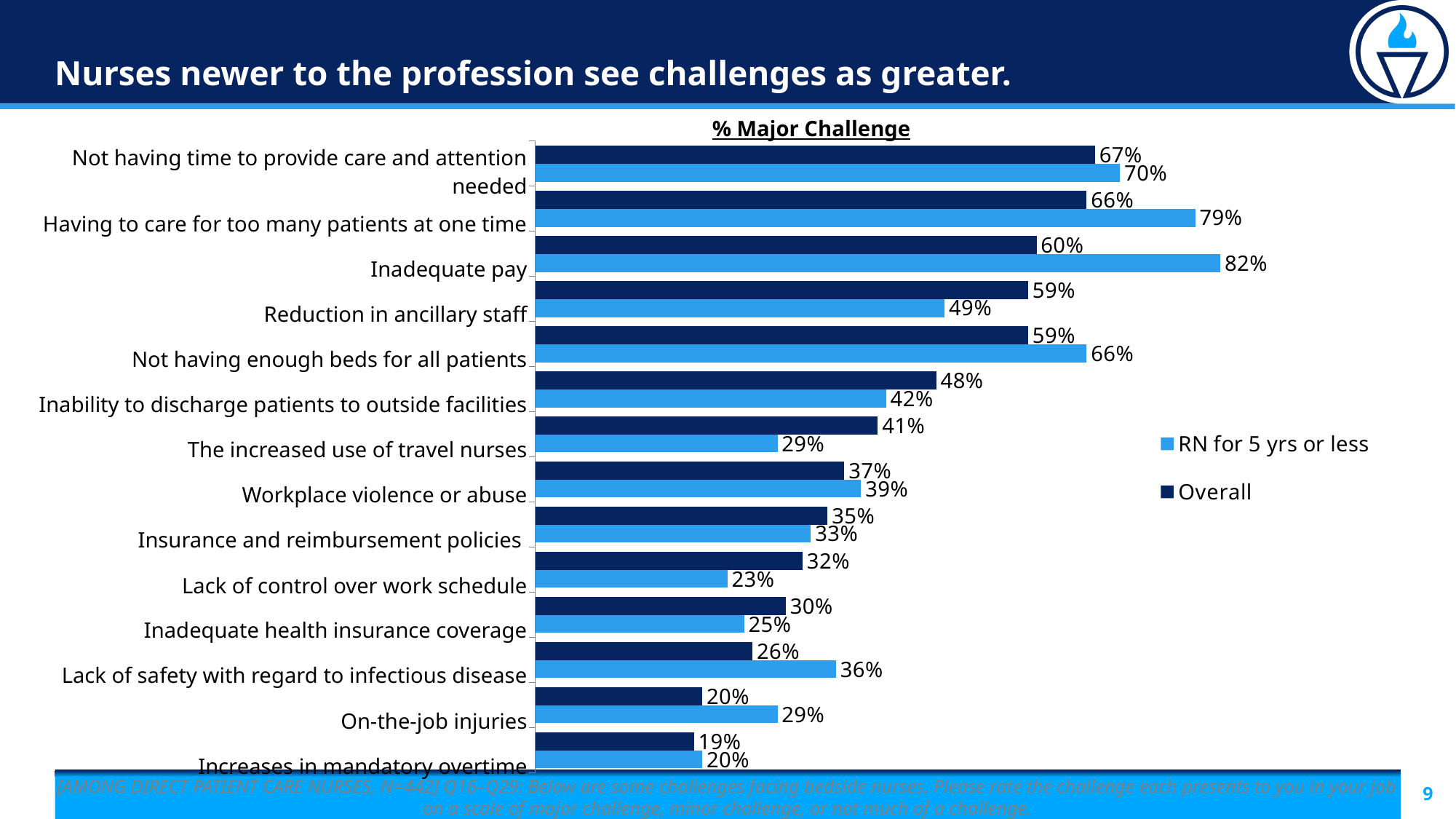
For The increased use of travel nurses, which is larger: the Overall value or the RN for 5 yrs or less value? Overall What is the Overall value for Inadequate pay? 60% How many challenge categories are shown on the chart? 14 Which category has the highest value for RN for 5 yrs or less? Inadequate pay What is the title of the chart? % Major Challenge What is the difference between the RN for 5 yrs or less value and the Overall value for Inadequate pay? 22% Which category has the lowest Overall value? Increases in mandatory overtime What is the value for RN for 5 yrs or less for Having to care for too many patients at one time? 79% What kind of chart is shown on the slide? Bar chart How many series does the legend list? 2 For Reduction in ancillary staff, which is larger: the Overall value or the RN for 5 yrs or less value? Overall What is the value for RN for 5 yrs or less for Lack of safety with regard to infectious disease? 36%